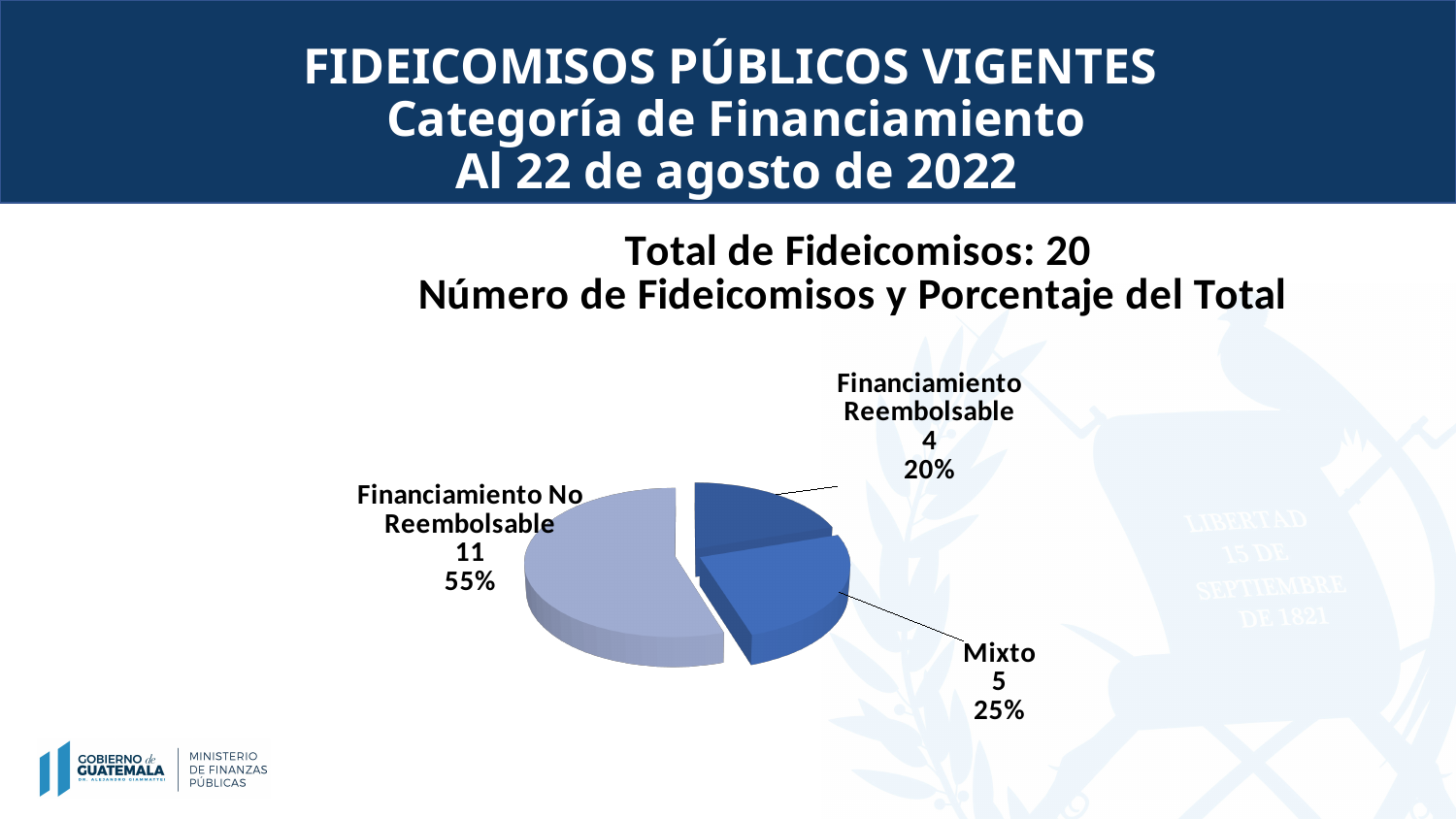
Which category has the largest number of fideicomisos? Financiamiento No Reembolsable What is the share of the pie for Financiamiento No Reembolsable? 55% How many fideicomisos are in the Mixto category? 5 How many fideicomisos are in the Financiamiento No Reembolsable category? 11 What is the difference in the number of fideicomisos between Financiamiento No Reembolsable and Mixto? 6 What share of the pie does Mixto represent? 25% Which has more fideicomisos, Mixto or Financiamiento Reembolsable? Mixto What percentage of the total does Financiamiento Reembolsable represent? 20% What kind of chart is shown on the slide? Pie chart How many slices does the pie chart have? 3 What is the total number of fideicomisos shown on the slide? 20 Which category has the smallest number of fideicomisos? Financiamiento Reembolsable